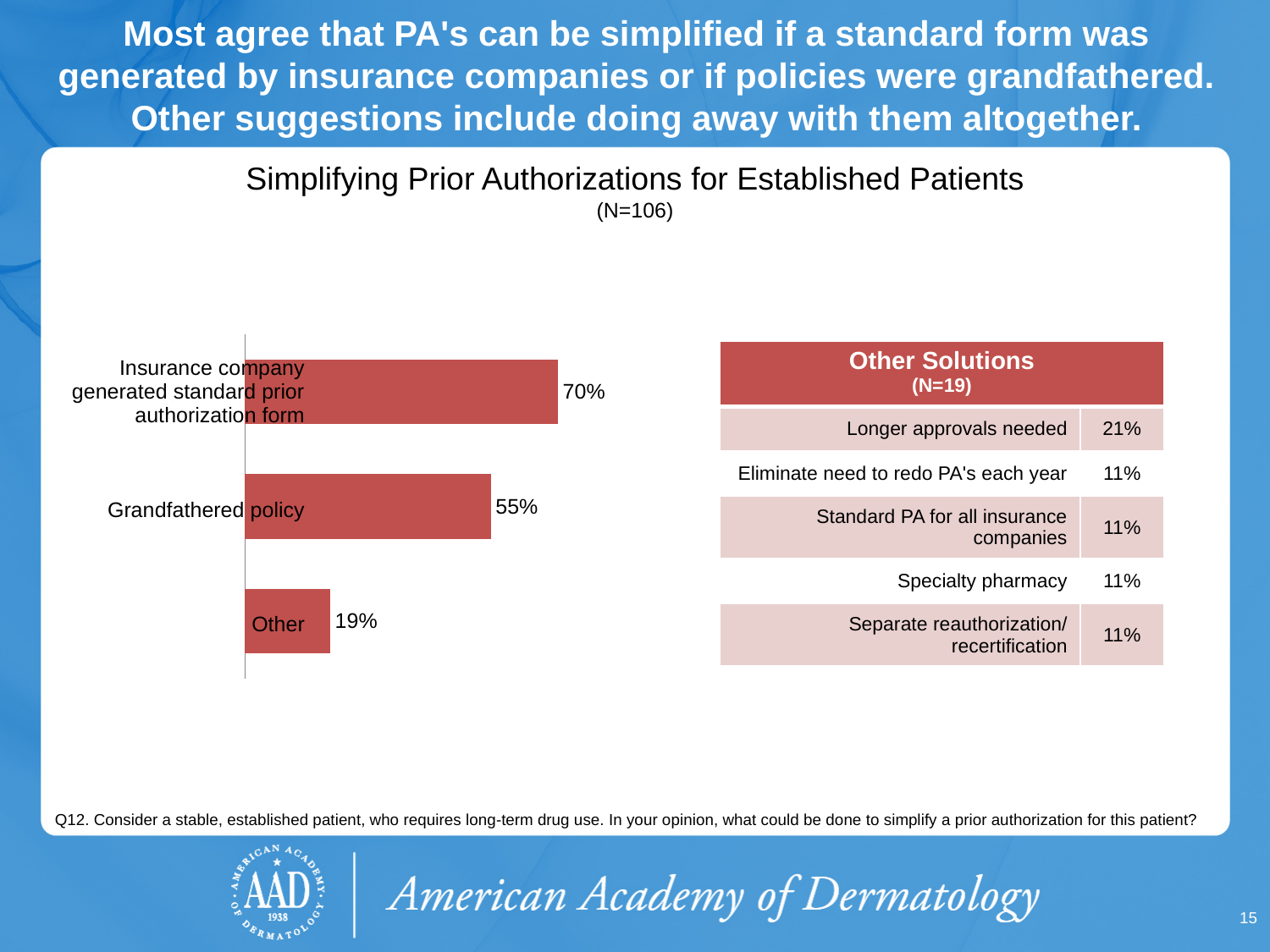
What is the difference between the values for Insurance company generated standard prior authorization form and Grandfathered policy? 15% What percentage of respondents suggested an insurance company generated standard prior authorization form? 70% What kind of chart is shown on the slide? Bar chart Which category has the highest value? Insurance company generated standard prior authorization form Which category has the lowest value? Other What is the value for Other? 19% What is the value for Grandfathered policy? 55% What is the difference between the values for Grandfathered policy and Other? 36% What is the title of the chart? Simplifying Prior Authorizations for Established Patients How many categories are shown in the bar chart? 3 What is the sample size (N) shown under the chart title? 106 Which is larger, the value for Grandfathered policy or the value for Other? Grandfathered policy